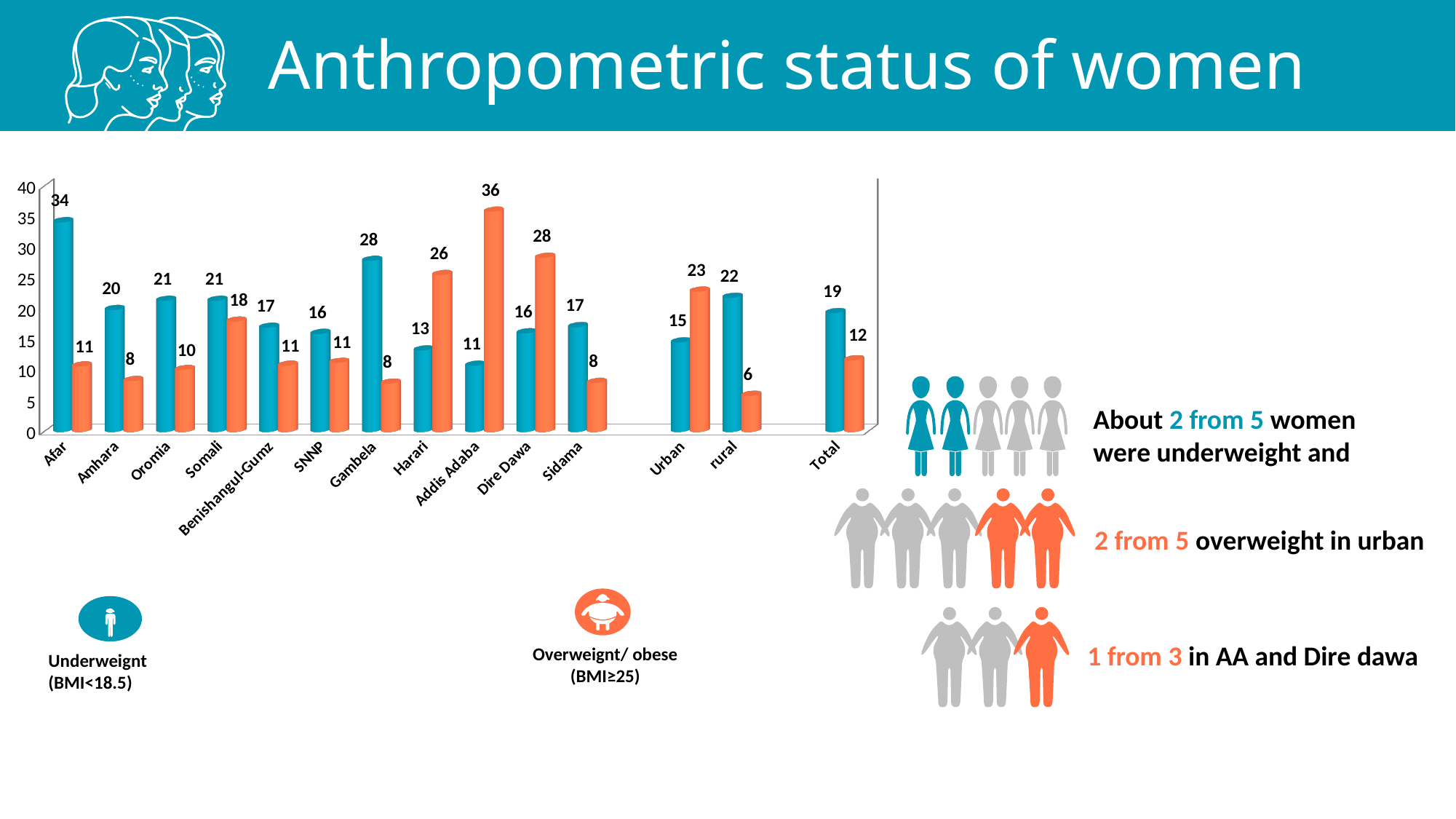
Which category has the highest underweight value? Afar Which category has the lowest overweight/obese value? rural Which is larger for Harari, the underweight value or the overweight/obese value? Overweight/obese What is the overweight/obese value for Addis Adaba? 36 How many categories are shown on the x axis of the chart? 14 What kind of chart is shown on the slide? Bar chart What is the overweight/obese value for Somali? 18 What is the title of the slide containing the chart? Anthropometric status of women What is the difference between the underweight and overweight/obese values for Dire Dawa? 12 How many series does the chart's legend list? 2 What is the underweight value for Afar? 34 What is the underweight value for Total? 19